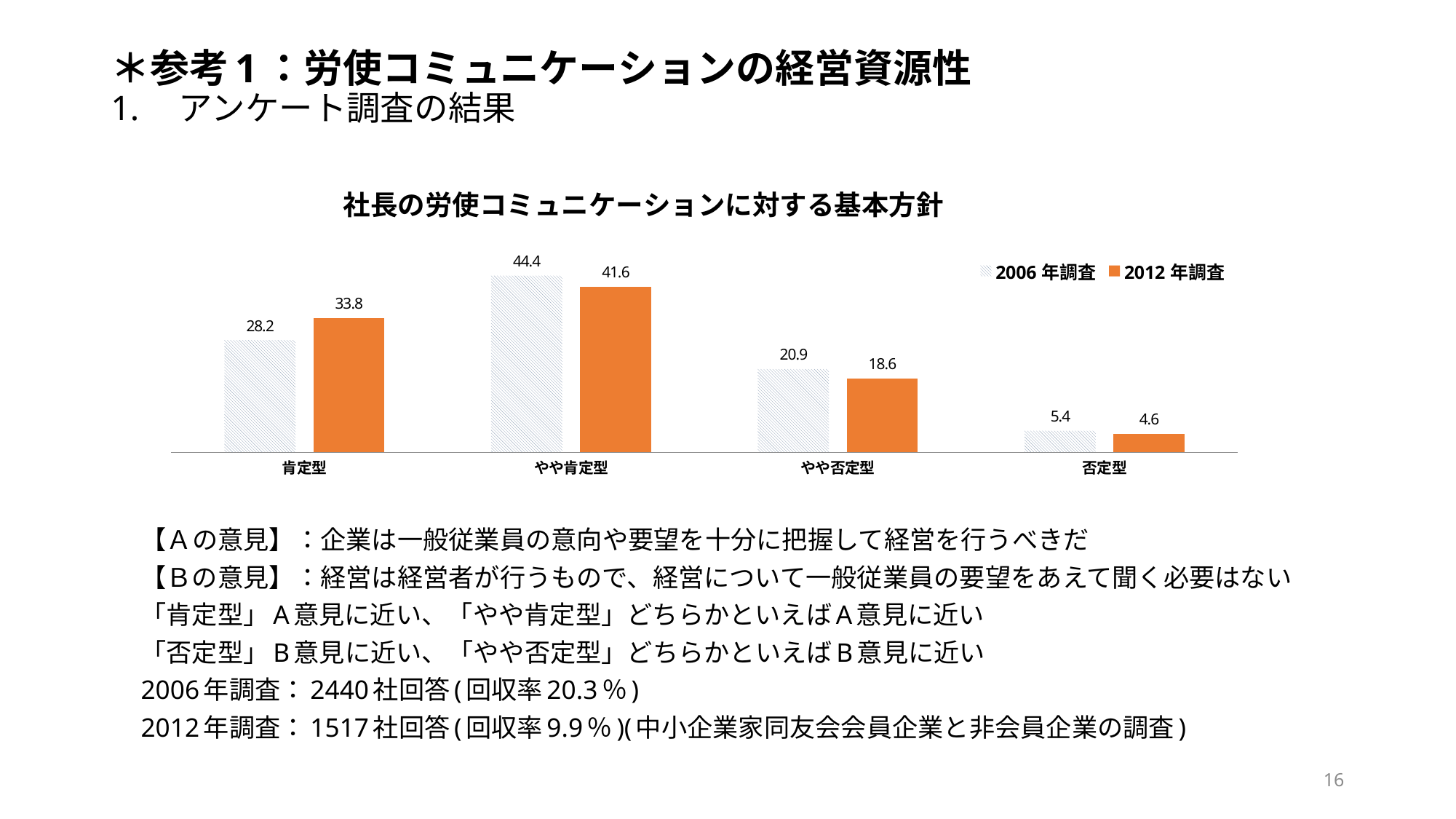
How many categories are shown on the x axis? 4 What is the difference between the 2006年調査 and 2012年調査 values for やや否定型? 2.3 What is the difference between the 2006年調査 and 2012年調査 values for 肯定型? 5.6 What is the title of the chart? 社長の労使コミュニケーションに対する基本方針 How many series does the legend list? 2 What is the value for 否定型 in the 2006年調査 series? 5.4 Which category has the lowest value in the 2006年調査 series? 否定型 What is the value for 肯定型 in the 2006年調査 series? 28.2 What is the value for やや肯定型 in the 2012年調査 series? 41.6 Which is larger for やや肯定型: the 2006年調査 value or the 2012年調査 value? 2006年調査 What kind of chart is shown on the slide? Bar chart Which category has the highest value in the 2012年調査 series? やや肯定型